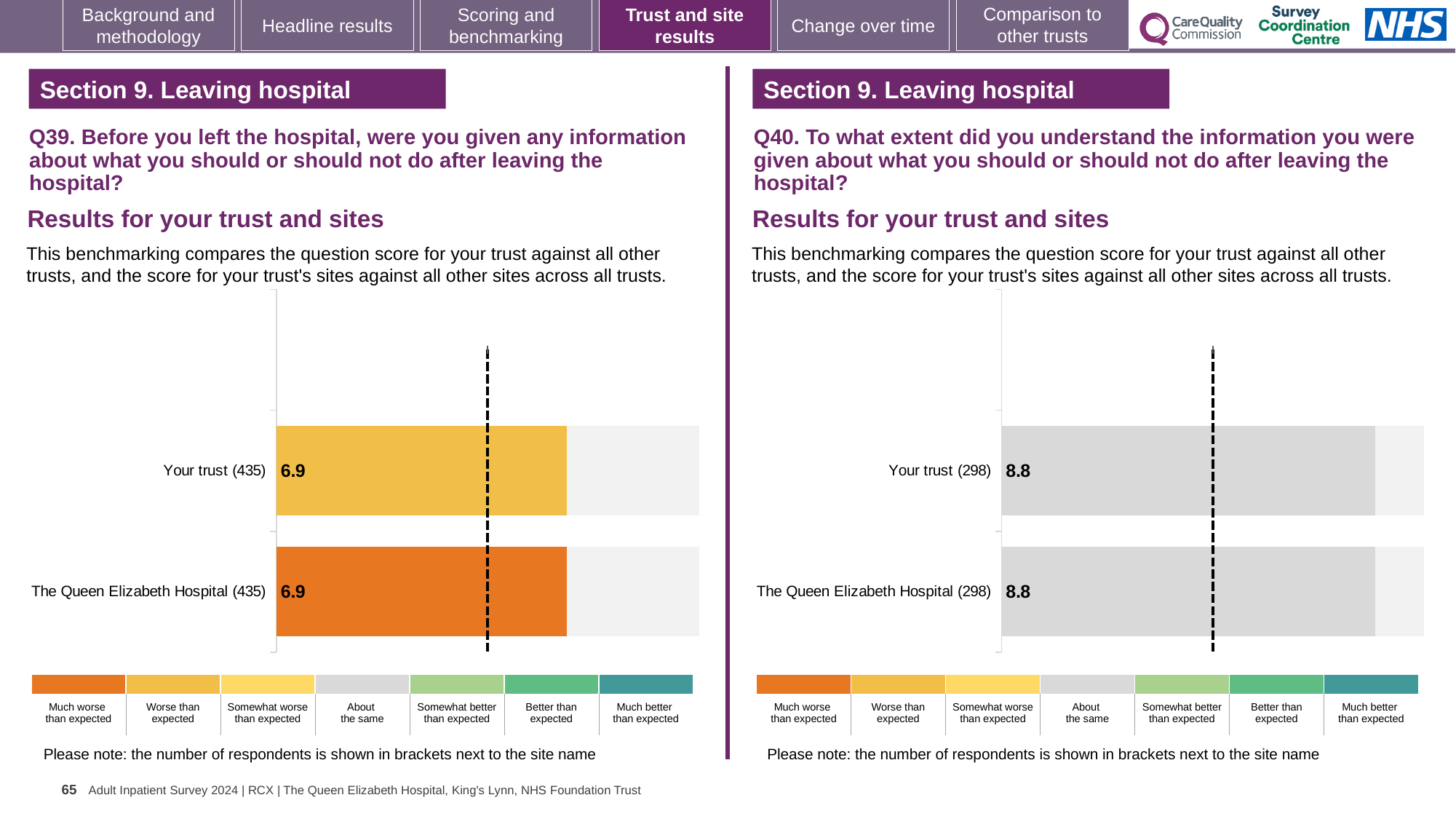
In the Q40 chart on the right, what is the score for The Queen Elizabeth Hospital? 8.8 How many categories does the colour key below the Q40 chart on the right list? 7 How many bars are plotted in the Q39 chart on the left? 2 What kind of chart is used for the Q39 results on the left? Bar chart In the Q39 chart on the left, what is the score for Your trust? 6.9 In the Q40 chart on the right, what is the difference between the score for Your trust and the score for The Queen Elizabeth Hospital? 0.0 In the Q40 chart on the right, how many respondents are shown in brackets next to The Queen Elizabeth Hospital? 298 How many bars are plotted in the Q40 chart on the right? 2 In the Q40 chart on the right, what is the score for Your trust? 8.8 In the Q39 chart on the left, what is the score for The Queen Elizabeth Hospital? 6.9 In the Q39 chart on the left, how many respondents are shown in brackets next to Your trust? 435 In the Q39 chart on the left, what is the difference between the score for Your trust and the score for The Queen Elizabeth Hospital? 0.0